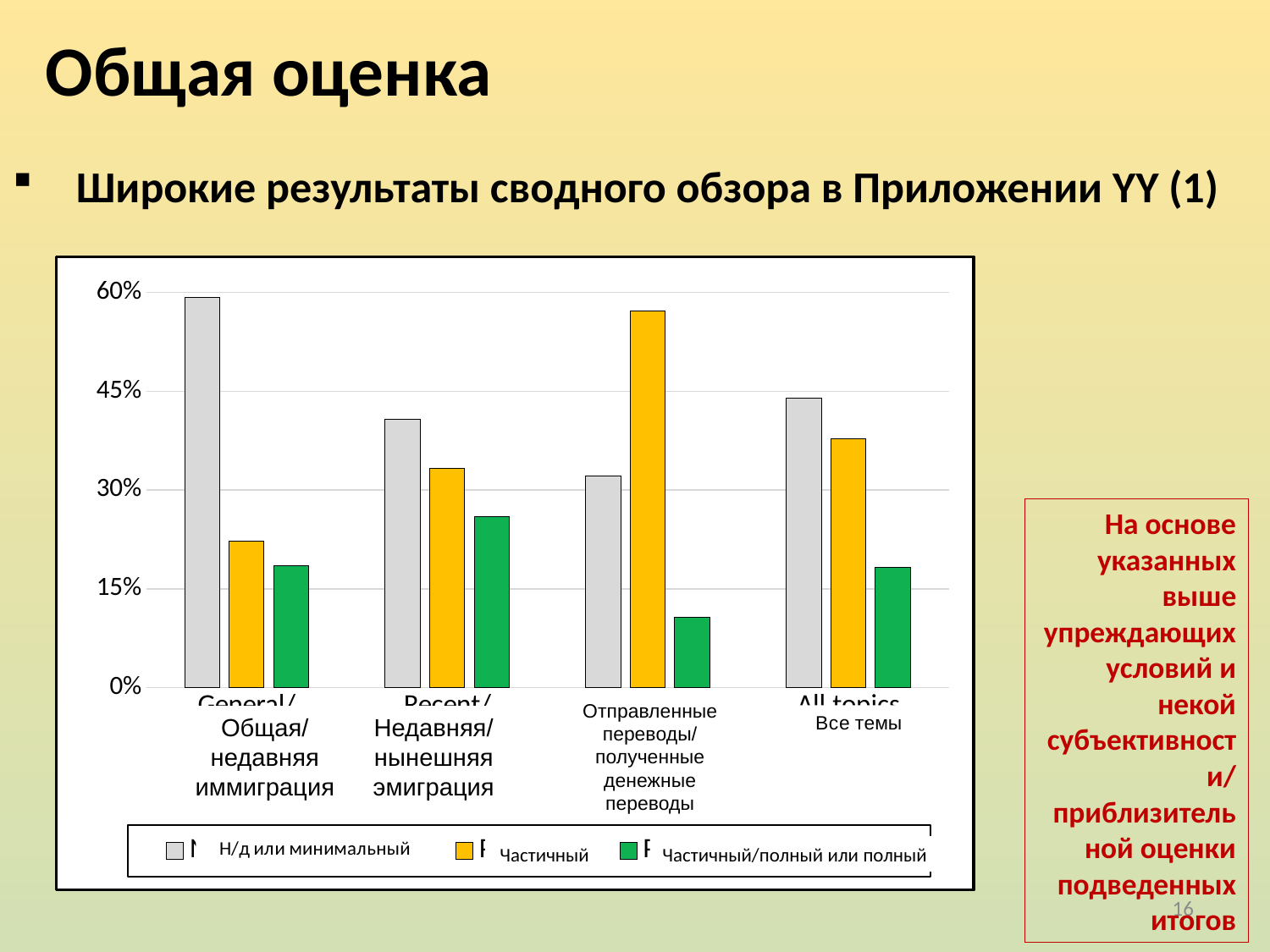
Is the value of 'Частичный/полный или полный' for 'Отправленные переводы/полученные денежные переводы' greater or less than 15%? less Which category has the highest 'Н/д или минимальный' bar? Общая/недавняя иммиграция In the 'Все темы' category, which is larger: 'Н/д или минимальный' or 'Частичный'? Н/д или минимальный What kind of chart is shown on the slide? Bar chart How many categories are shown along the x axis of the chart? 4 How many series does the chart's legend list? 3 Is the value of 'Частичный' for 'Отправленные переводы/полученные денежные переводы' greater or less than 45%? greater Is the value of 'Частичный' for 'Все темы' greater or less than 30%? greater Which series has the highest bar in the 'Отправленные переводы/полученные денежные переводы' category? Частичный Which category has the lowest 'Частичный/полный или полный' bar? Отправленные переводы/полученные денежные переводы